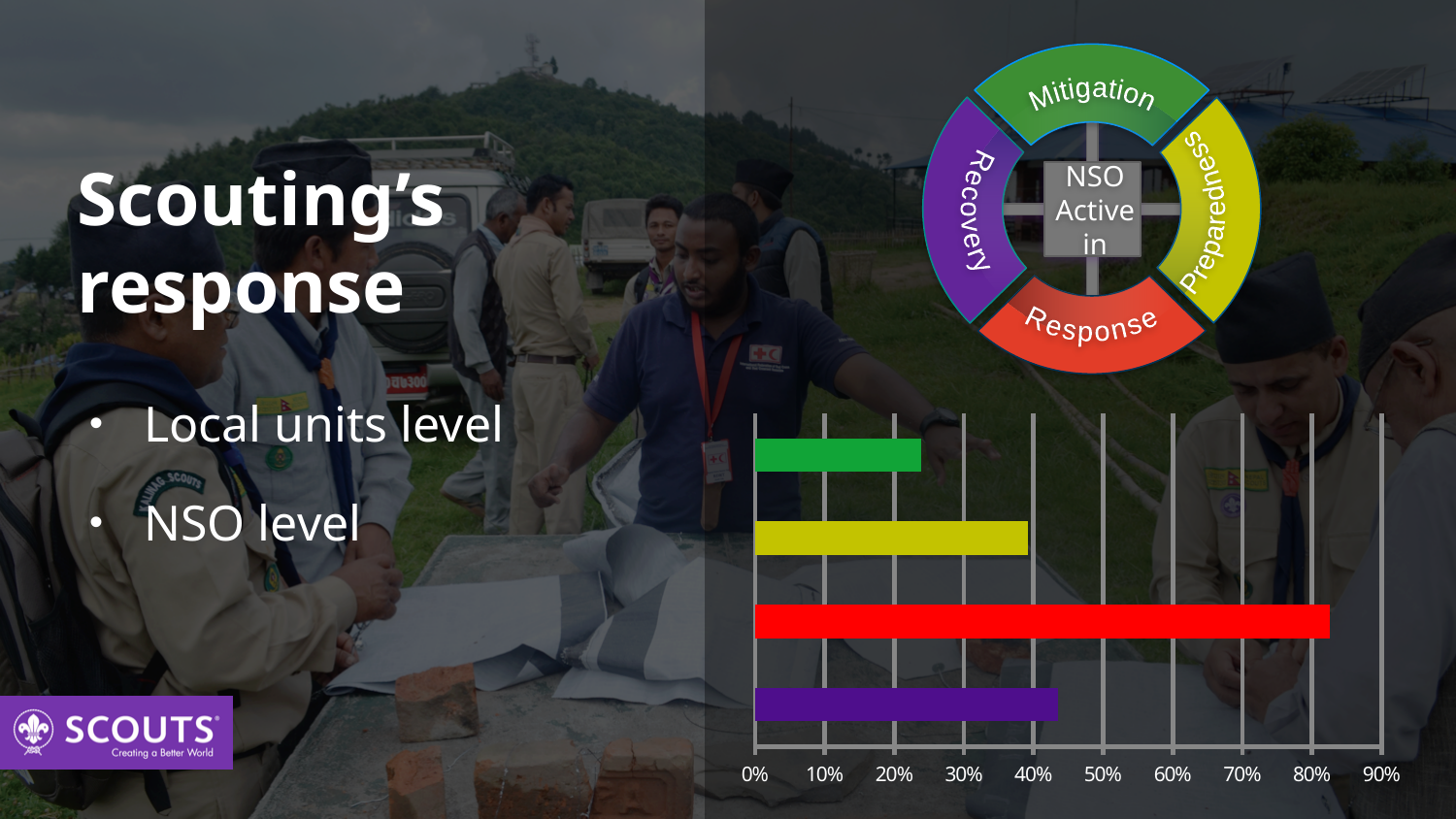
Is the value of the green bar greater or less than 30%? less What is the highest tick label shown on the x axis of the bar chart? 90% Which bar in the bar chart is the longest? the red bar Is the value of the red bar greater or less than 80%? greater Which is larger in the bar chart, the purple bar or the yellow bar? the purple bar Is the value of the green bar greater or less than 20%? greater How many bars does the bar chart show? 4 What kind of chart is shown at the bottom right of the slide? bar chart Which bar in the bar chart is the shortest? the green bar Which is larger in the bar chart, the red bar or the green bar? the red bar